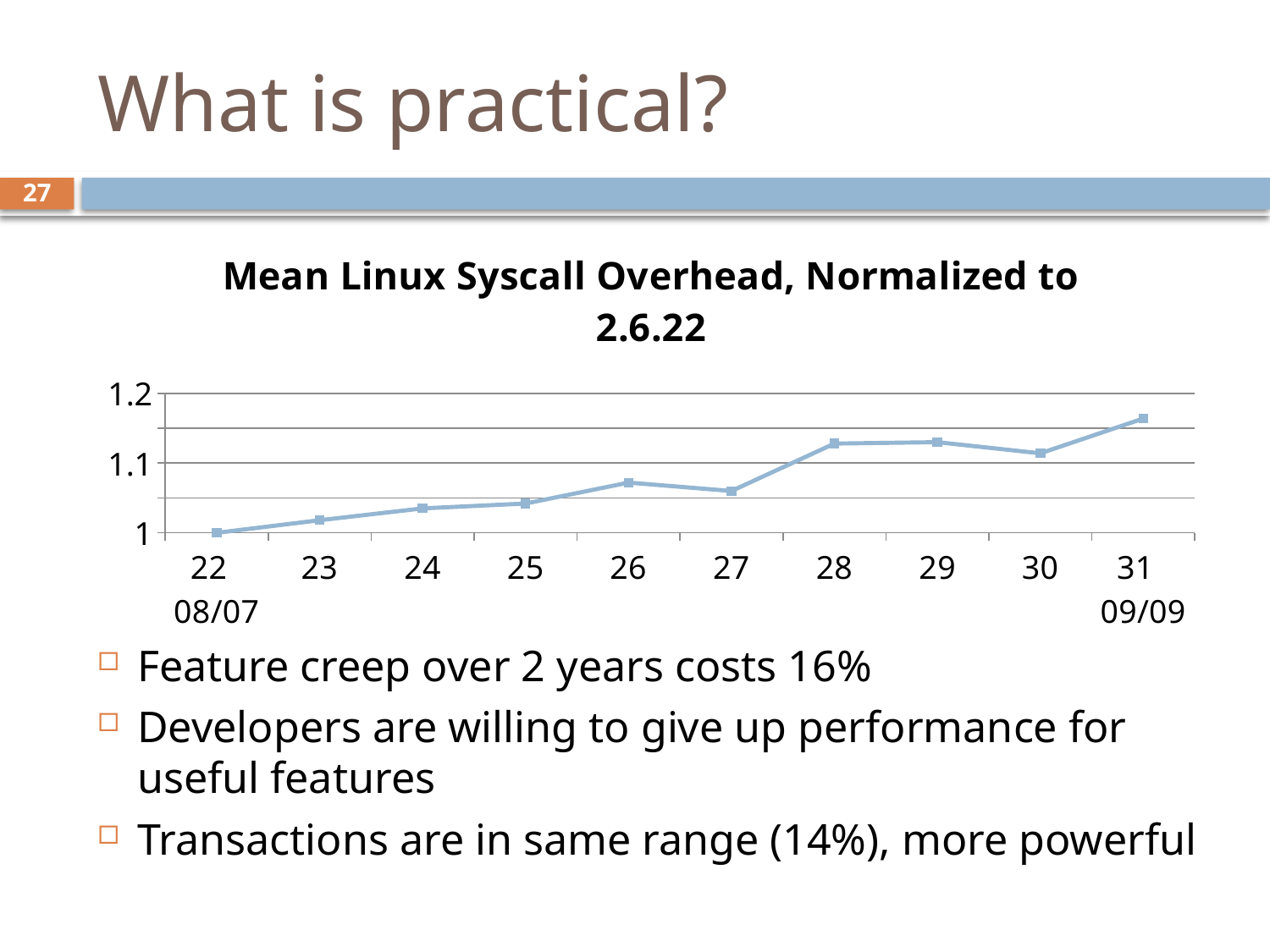
Which version has the lowest normalized syscall overhead? 22 Which has the larger overhead value, version 28 or version 27? 28 Is the value for version 27 greater or less than 1.1? less Is the value for version 31 greater or less than 1.2? less Which version has the highest normalized syscall overhead? 31 Is the value for version 28 greater or less than 1.1? greater What is the title of the chart? Mean Linux Syscall Overhead, Normalized to 2.6.22 What kind of chart is shown on the slide? line chart How many kernel versions are plotted along the x axis? 10 What is the normalized overhead value for version 22? 1 Overall, do the values rise or fall from version 22 to version 31? rise Which has the larger overhead value, version 31 or version 30? 31